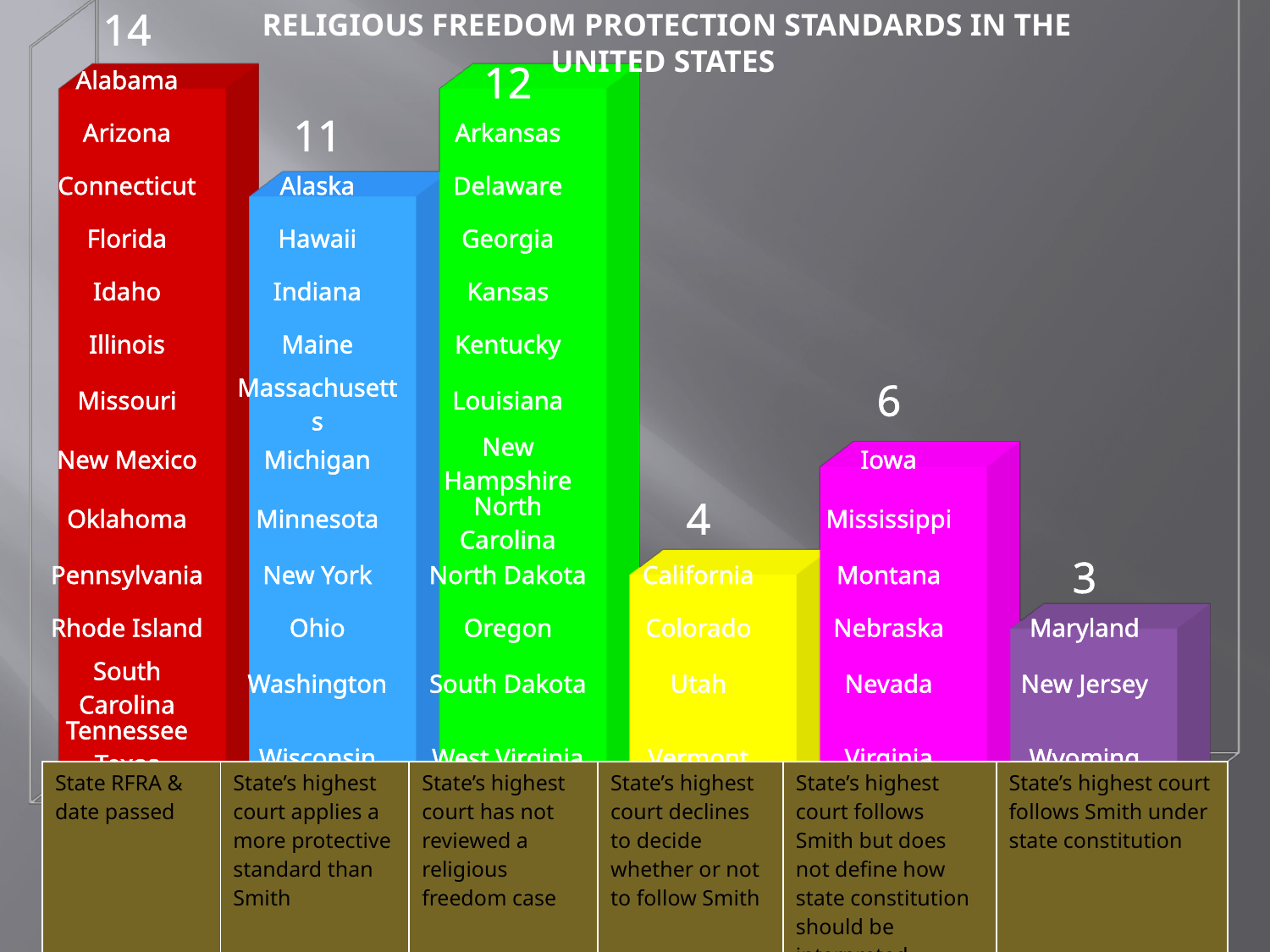
What is the value of the bar for "State's highest court declines to decide whether or not to follow Smith"? 4 What is the value of the bar for "State's highest court has not reviewed a religious freedom case"? 12 What is the value of the bar for "State's highest court follows Smith under state constitution"? 3 Which category has the highest value? State RFRA & date passed What is the value of the bar for "State's highest court applies a more protective standard than Smith"? 11 What is the difference between the value for "State RFRA & date passed" and the value for "State's highest court follows Smith but does not define how state constitution should be interpreted"? 8 Which is larger: the value for "State's highest court applies a more protective standard than Smith" or the value for "State's highest court has not reviewed a religious freedom case"? State's highest court has not reviewed a religious freedom case What kind of chart is shown on the slide? bar chart What is the value of the bar for "State RFRA & date passed"? 14 How many bars does the chart have? 6 Which category has the lowest value? State's highest court follows Smith under state constitution What is the title of the chart? Religious Freedom Protection Standards in the United States